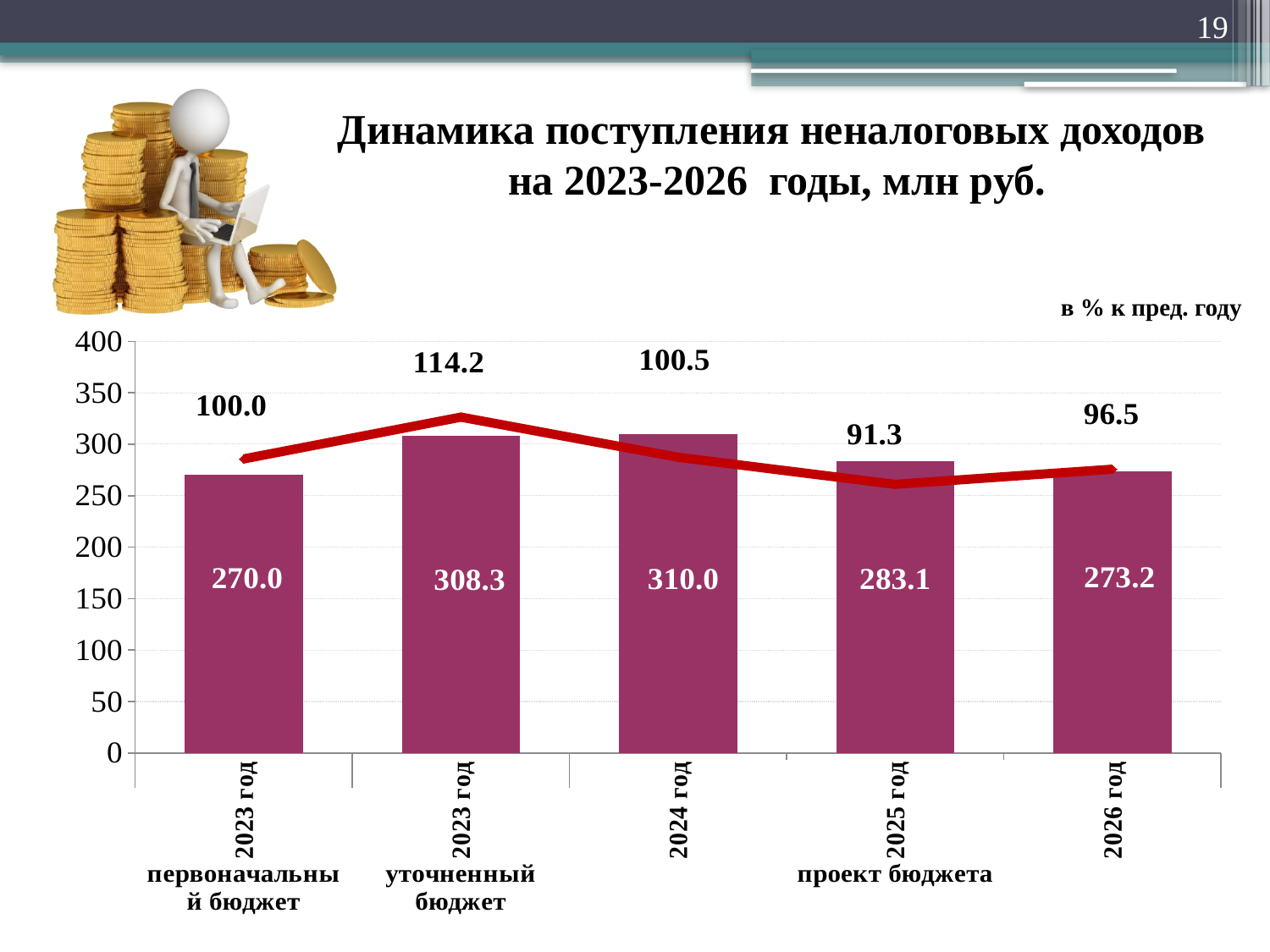
What is the title of the chart? Динамика поступления неналоговых доходов на 2023-2026 годы, млн руб. What is the value of the bar for 2023 год (уточненный бюджет)? 308.3 What is the difference between the bar values for 2024 год and 2025 год? 26.9 Which category has the lowest bar value? 2023 год (первоначальный бюджет) Which category has the highest bar value? 2024 год Do the bar values rise or fall from 2024 год to 2026 год? fall How many bars are plotted in the chart? 5 Which is larger, the bar value for 2025 год or for 2026 год? 2025 год What percentage to the previous year (в % к пред. году) is shown for 2023 год (уточненный бюджет)? 114.2 What is the value of the bar for 2024 год? 310.0 What is the value of the bar for 2026 год? 273.2 What percentage to the previous year (в % к пред. году) is shown for 2025 год? 91.3